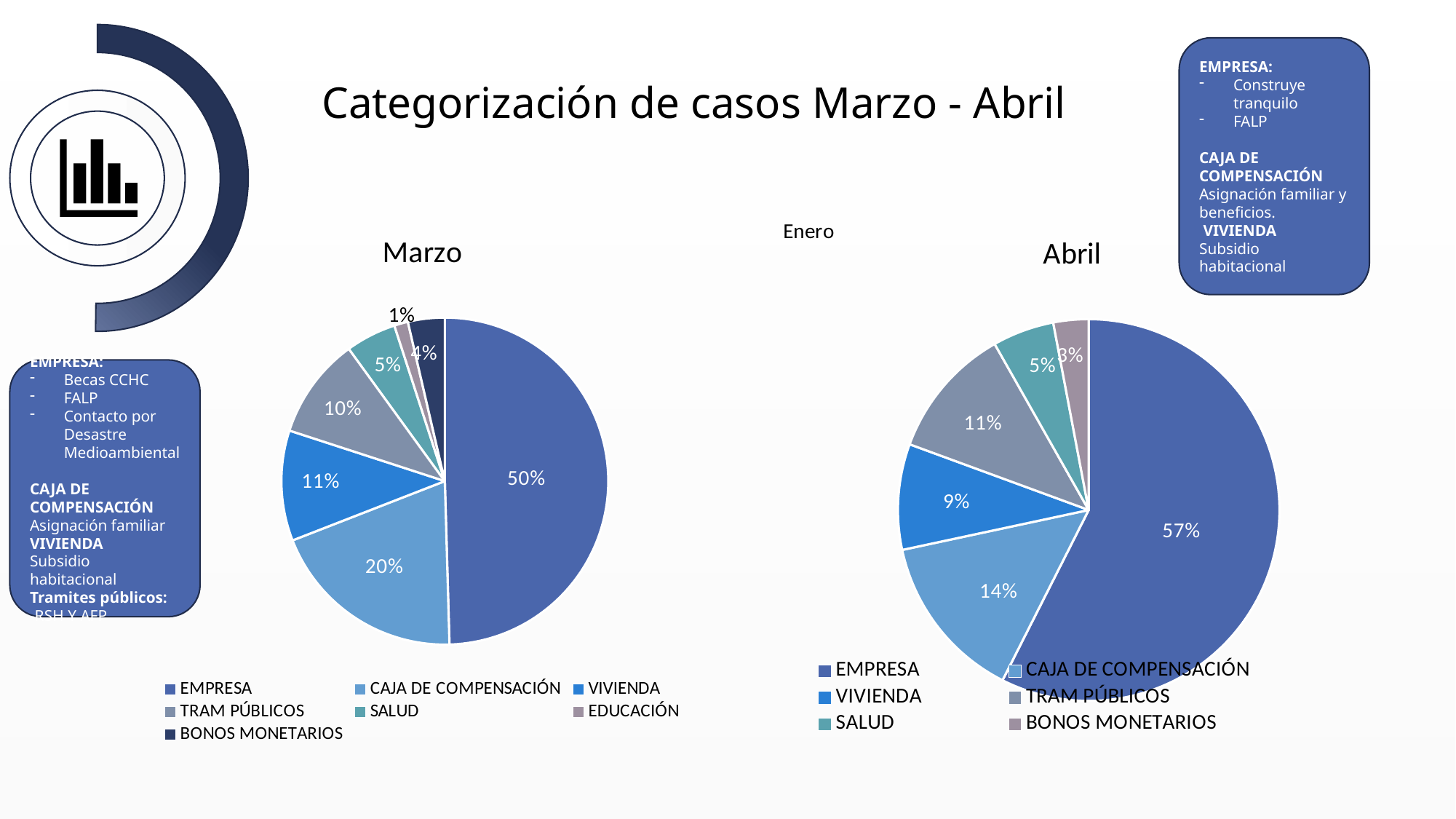
In the Abril chart, what share of cases is EMPRESA? 57% How many categories does the legend of the Abril chart list? 6 In the Abril chart, what percentage is shown for VIVIENDA? 9% In the Abril chart, which category has the largest slice? EMPRESA What type of chart is used for Marzo and Abril? Pie chart In the Abril chart, what percentage is shown for BONOS MONETARIOS? 3% In the Marzo chart, what share of cases is EMPRESA? 50% In the Marzo chart, which is larger: VIVIENDA or TRAM PÚBLICOS? VIVIENDA In the Marzo chart, which category has the smallest slice? EDUCACIÓN What is the difference between the EMPRESA share in Abril and the EMPRESA share in Marzo? 7% In the Marzo chart, what percentage is shown for CAJA DE COMPENSACIÓN? 20% How many categories does the legend of the Marzo chart list? 7